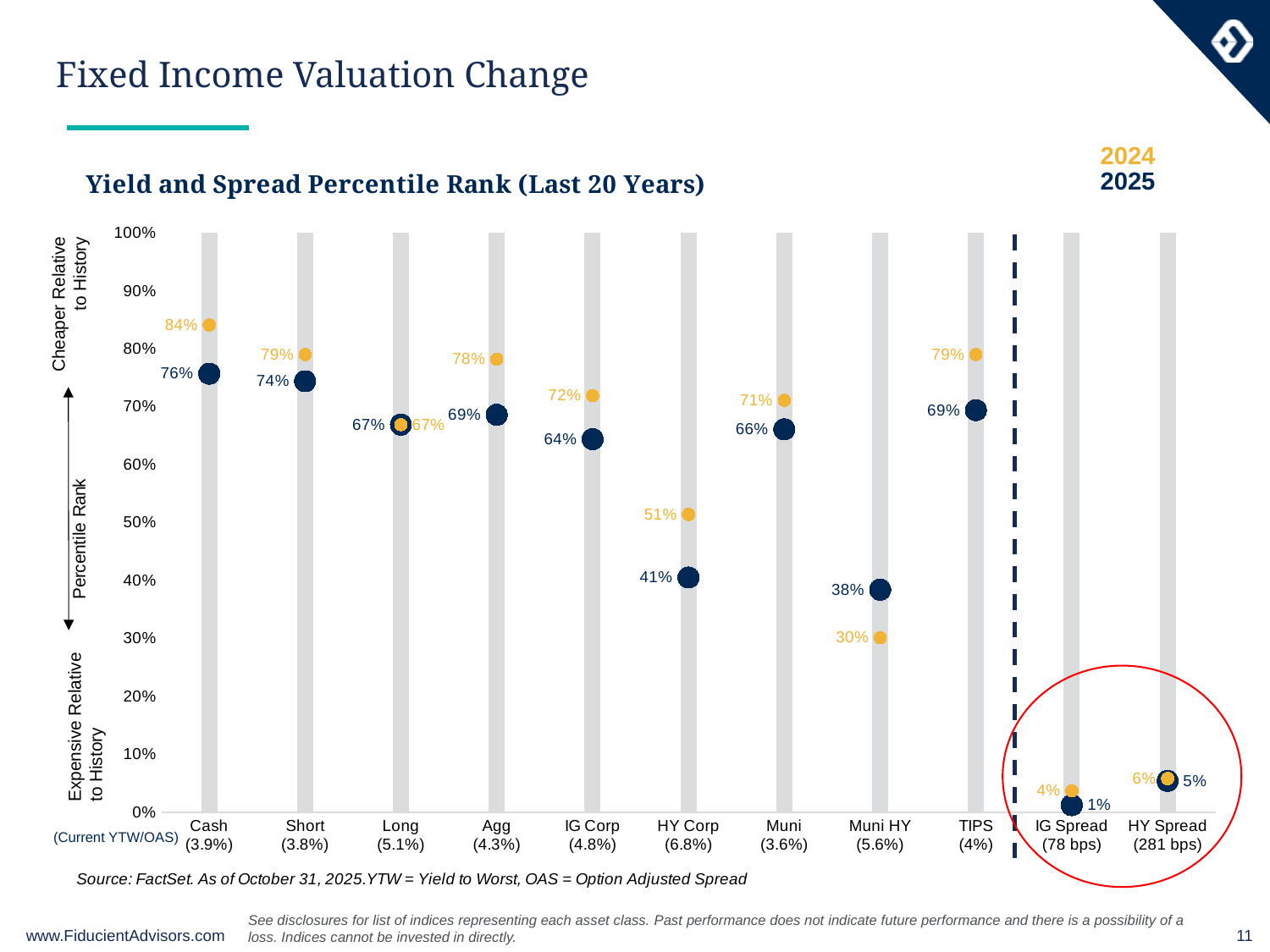
What is the 2025 percentile rank for Cash? 76% Which category has the lowest 2025 percentile rank? IG Spread What is the 2024 percentile rank for HY Corp? 51% What is the difference between the 2024 and 2025 percentile ranks for Agg? 9% What is the 2025 percentile rank for Muni HY? 38% Which is larger for Muni HY, the 2024 value or the 2025 value? 2025 Which colour represents the 2024 series? Yellow/gold Which category has the highest 2024 percentile rank? Cash What kind of chart is this? Scatter (dot) chart What is the current YTW shown under the Long category? 5.1% How many categories are shown on the x axis? 11 How many series does the legend list? 2